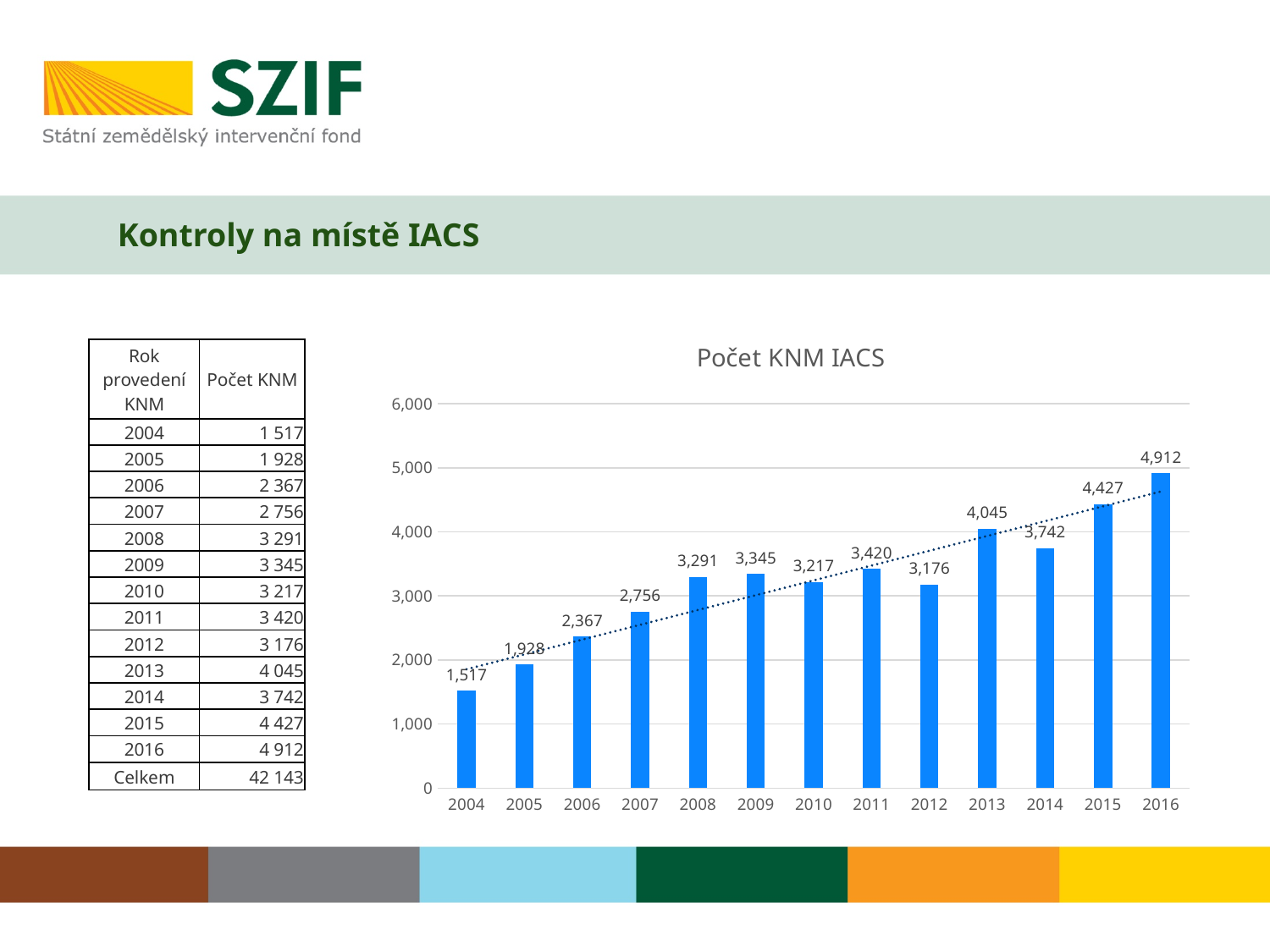
What is the value for 2016 in the chart? 4,912 What is the value for 2012 in the chart? 3,176 How many years are shown on the x axis of the chart? 13 What kind of chart is shown on the slide? bar chart Which year has the lowest value in the chart? 2004 What is the title of the chart? Počet KNM IACS What is the difference between the values for 2016 and 2015? 485 What is the value for 2004 in the chart? 1,517 Which year has the highest value in the chart? 2016 What is the difference between the values for 2013 and 2014? 303 Which is larger, the value for 2009 or the value for 2010? 2009 Is the value for 2013 greater or less than 4,000? greater